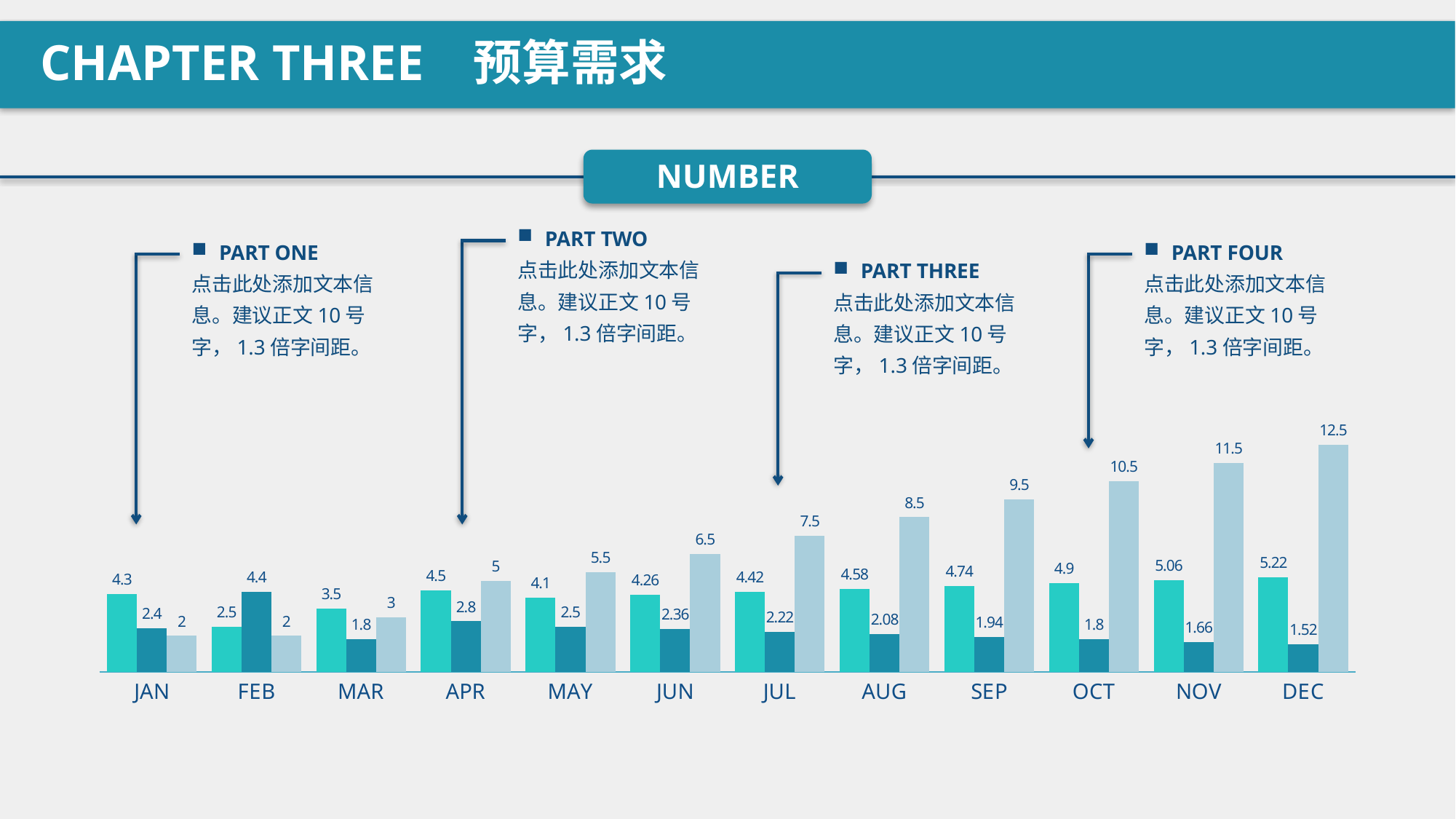
What is the value of the light blue (third) bar for DEC? 12.5 What type of chart is shown on the slide? bar chart What is the title shown in the box above the chart? NUMBER Do the light blue (third) bar values rise or fall from APR to DEC? rise What is the difference between the light blue (third) bar values for DEC and NOV? 1 Which month has the highest light blue (third) bar? DEC Which is larger for MAR: the bright teal (first) bar or the light blue (third) bar? the bright teal (first) bar How many bars are plotted for each month in the chart? 3 Which month has the lowest dark teal (second) bar? DEC How many months are shown along the x axis of the chart? 12 What is the value of the dark teal (second) bar for FEB? 4.4 What is the value of the bright teal (first) bar for SEP? 4.74